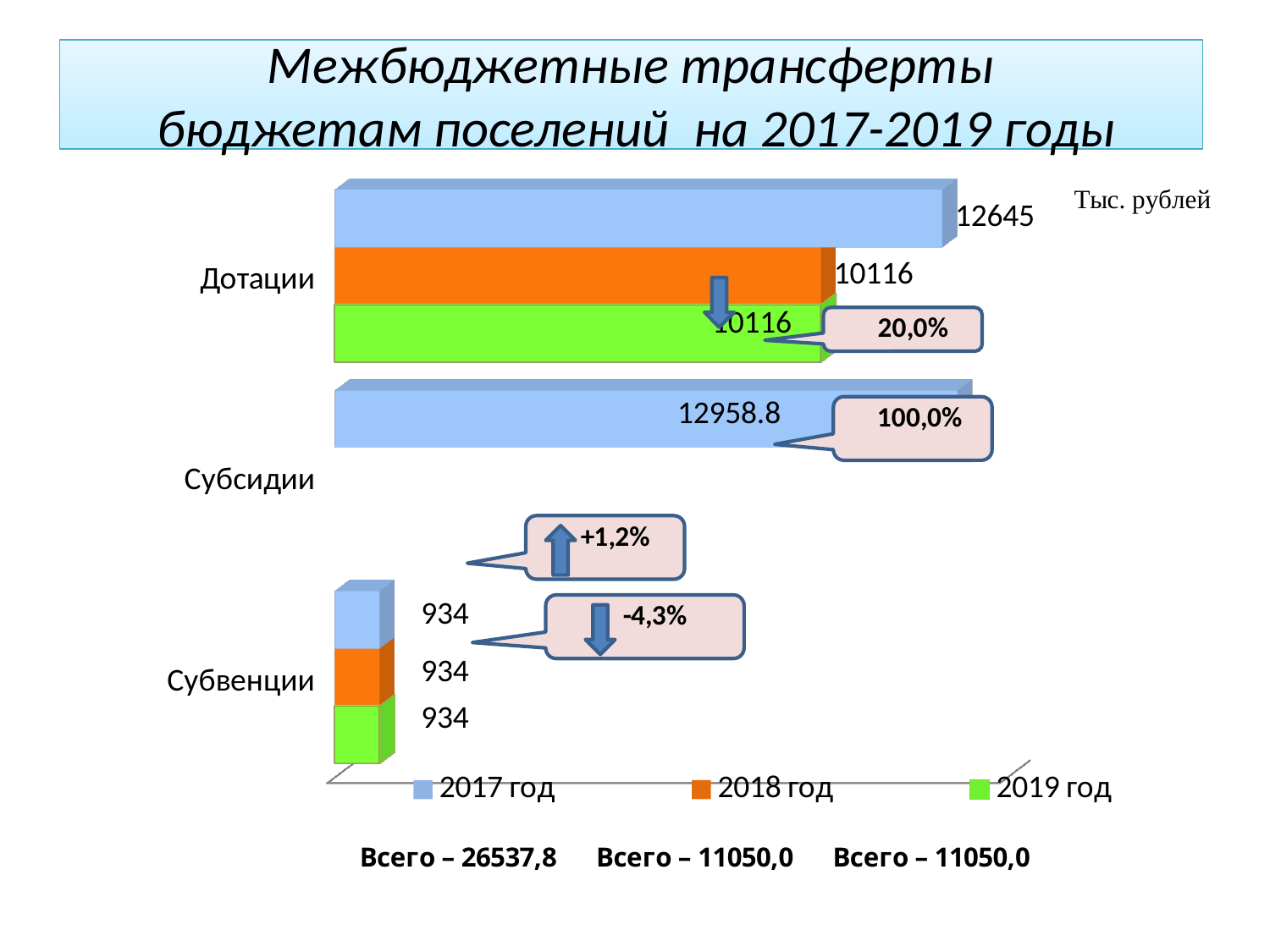
What is the value for Субвенции in 2019 год? 934 What is the difference between the 2017 год and 2018 год values for Дотации? 2529 What is the value for Субсидии in 2017 год? 12958.8 Which is larger for 2017 год: Дотации or Субсидии? Субсидии How many series does the legend list? 3 Which category has the lowest value in 2017 год? Субвенции How many categories are shown on the chart? 3 Which category has the highest value in 2017 год? Субсидии What is the value for Дотации in 2017 год? 12645 What kind of chart is shown on the slide? Bar chart Which colour represents 2019 год in the legend? Green What is the value for Дотации in 2018 год? 10116